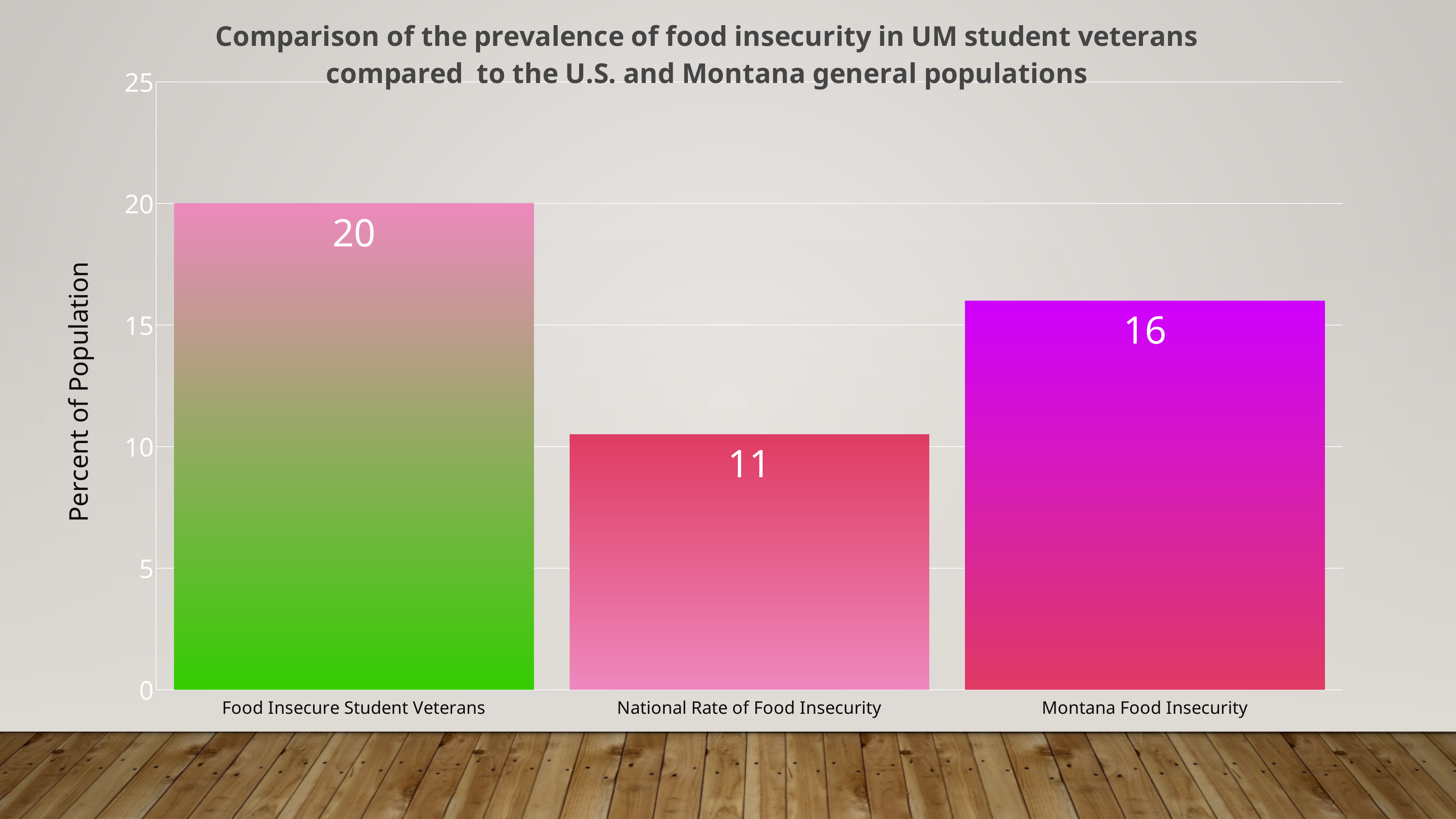
Which is larger, the value for Montana Food Insecurity or the value for National Rate of Food Insecurity? Montana Food Insecurity What kind of chart is shown on the slide? bar chart Which category has the lowest value? National Rate of Food Insecurity Is the value for Montana Food Insecurity greater or less than 15? greater What is the value for Food Insecure Student Veterans? 20 What is the value for Montana Food Insecurity? 16 What is the difference between the values for Food Insecure Student Veterans and National Rate of Food Insecurity? 9 Which category has the highest value? Food Insecure Student Veterans What is the value for National Rate of Food Insecurity? 11 What is the difference between the values for Montana Food Insecurity and National Rate of Food Insecurity? 5 What is the label of the vertical axis? Percent of Population How many categories are shown in the chart? 3